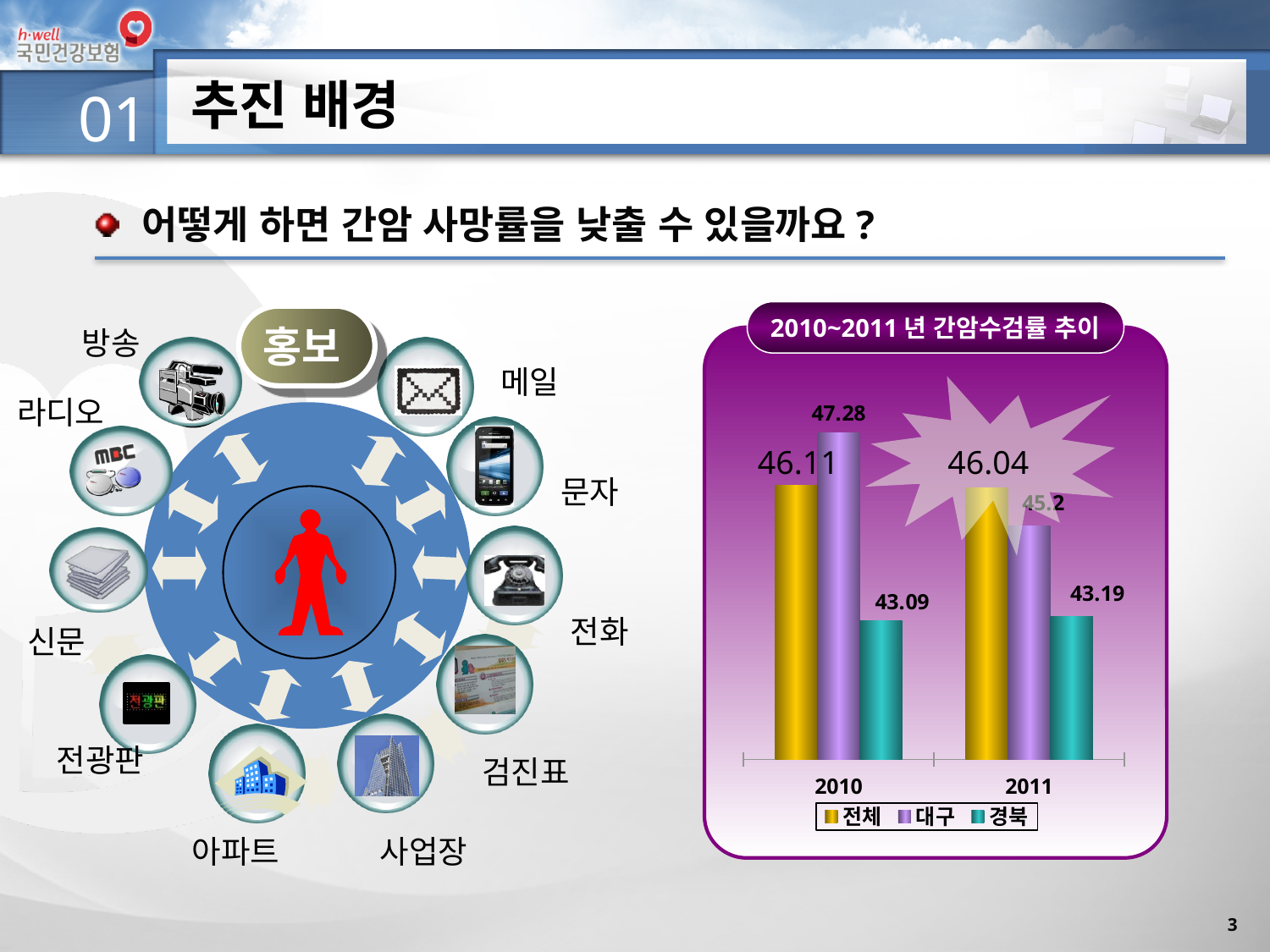
What is the difference between the 대구 values for 2010 and 2011? 2.08 What is the chart's title? 2010~2011 년 간암수검률 추이 What is the value for 전체 in 2011? 46.04 What is the value for 경북 in 2011? 43.19 What is the value for 대구 in 2010? 47.28 Which is larger, the 전체 value in 2010 or the 대구 value in 2011? 전체 in 2010 Which series has the highest value in 2010? 대구 What type of chart is shown on the slide? bar chart Which series has the lowest value in 2011? 경북 Does the 대구 value rise or fall from 2010 to 2011? fall How many year categories are shown on the x axis? 2 How many series does the legend list? 3